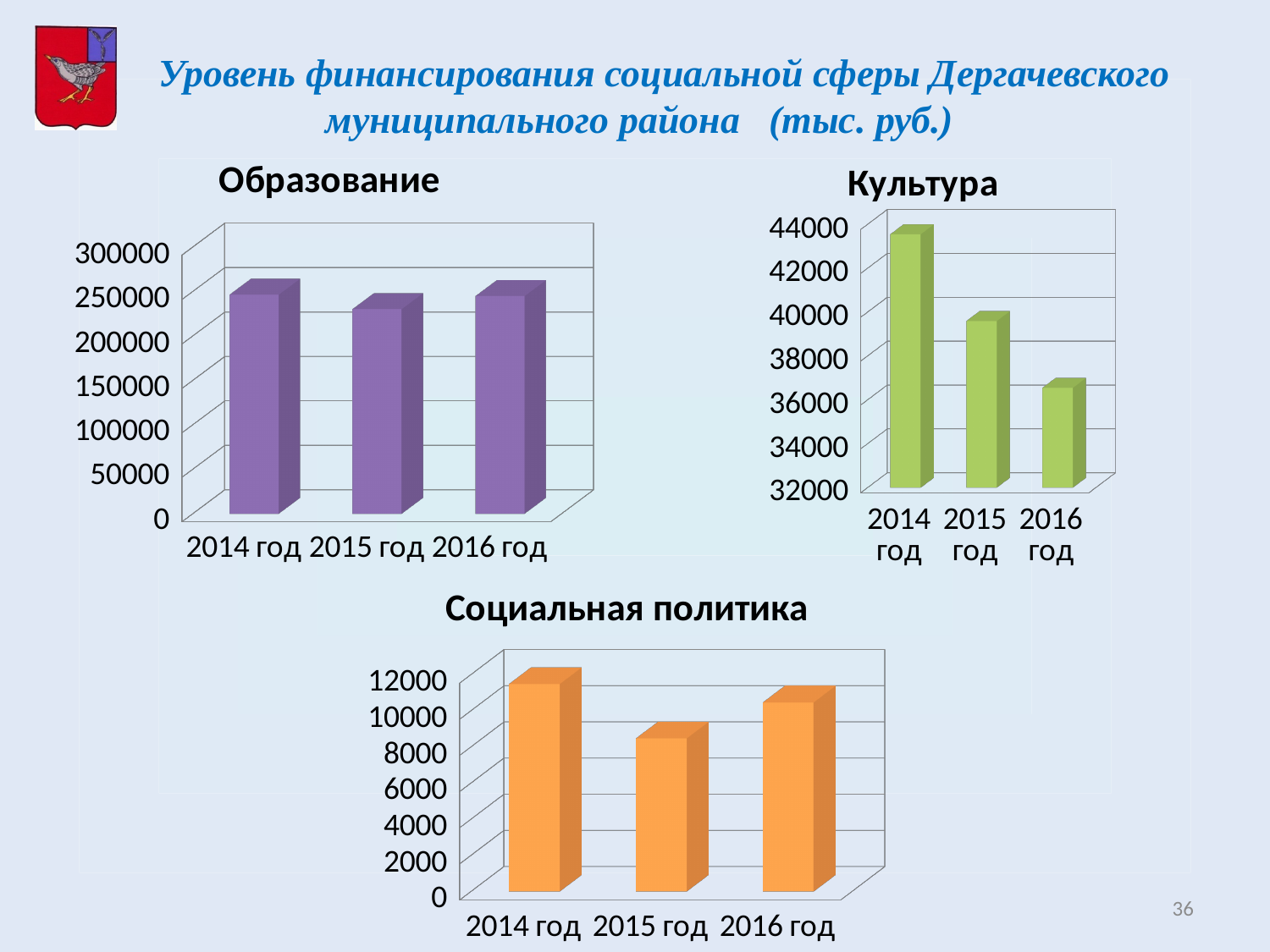
On the "Образование" chart, which year has the lowest value? 2015 год On the "Социальная политика" chart, is the value for 2015 год greater or less than 10000? less On the "Культура" chart, do the values rise or fall from 2014 год to 2016 год? fall On the "Образование" chart, is the value for 2014 год greater or less than 300000? less On the "Культура" chart, is the value for 2016 год greater or less than 38000? less What type of chart is the "Образование" chart? bar chart On the "Культура" chart, which is larger, the value for 2015 год or 2016 год? 2015 год How many years are shown on the "Образование" chart? 3 On the "Культура" chart, which year has the highest value? 2014 год On the "Социальная политика" chart, which year has the lowest value? 2015 год What colour are the bars on the "Социальная политика" chart? orange